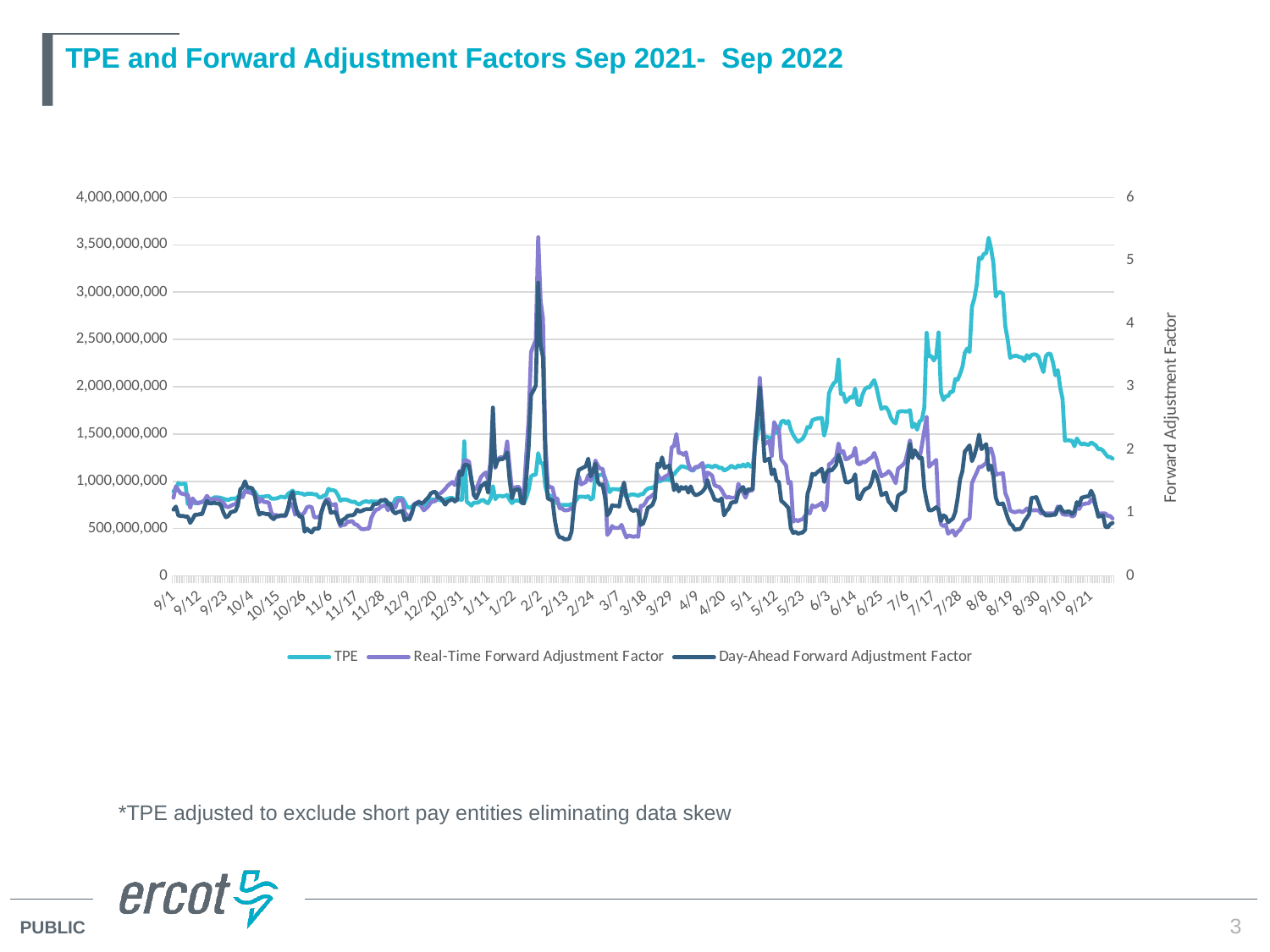
Is the peak value of the TPE line (around 8/8) greater or less than 3,000,000,000? greater Is the TPE value at the start of the series (9/1) greater or less than 1,000,000,000? less Is the TPE value at the end of the series (9/21) greater or less than 1,000,000,000? greater What is the title of the chart? TPE and Forward Adjustment Factors Sep 2021- Sep 2022 In which month does the TPE line reach its highest point? August How many series does the legend list? 3 What is the label on the right-hand vertical axis? Forward Adjustment Factor What kind of chart is shown on the slide? Line chart Does the TPE line rise or fall between 8/8 and 9/21? Fall Which of the two Forward Adjustment Factor series reaches the higher peak value? Real-Time Forward Adjustment Factor